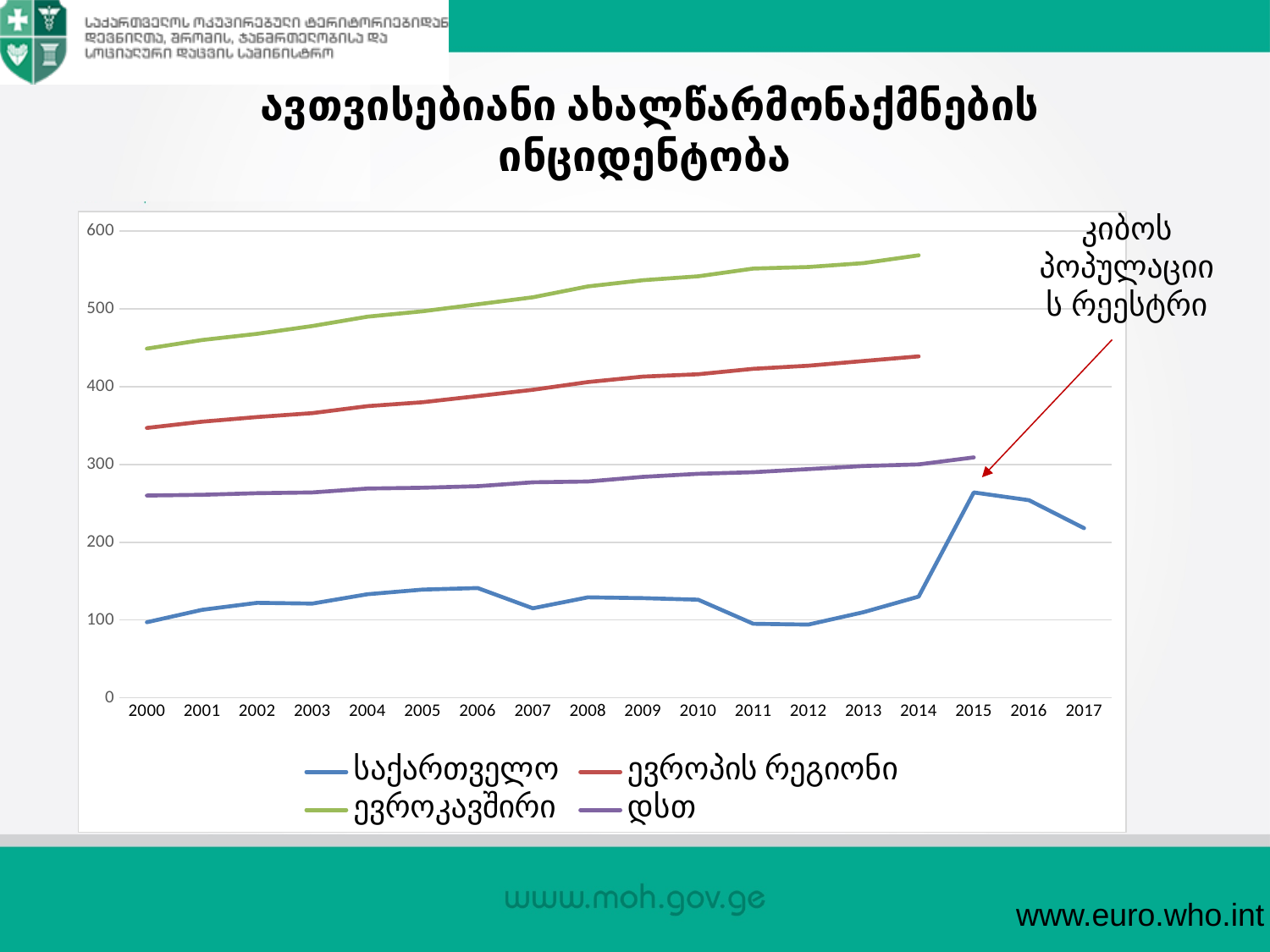
How many years are labelled on the x axis? 18 Which series has the highest values across the chart? ევროკავშირი What is the title of the chart on the slide? ავთვისებიანი ახალწარმონაქმნების ინციდენტობა In 2010, which is larger: ევროკავშირი or ევროპის რეგიონი? ევროკავშირი Is the value for საქართველო in 2015 greater or less than 200? greater How many series does the legend list? 4 Which series has the lowest values across the chart? საქართველო Is the value for ევროპის რეგიონი in 2000 greater or less than 300? greater Do the values for ევროკავშირი rise or fall from 2000 to 2014? rise Is the value for დსთ in 2000 greater or less than 300? less What kind of chart is shown on the slide? line chart